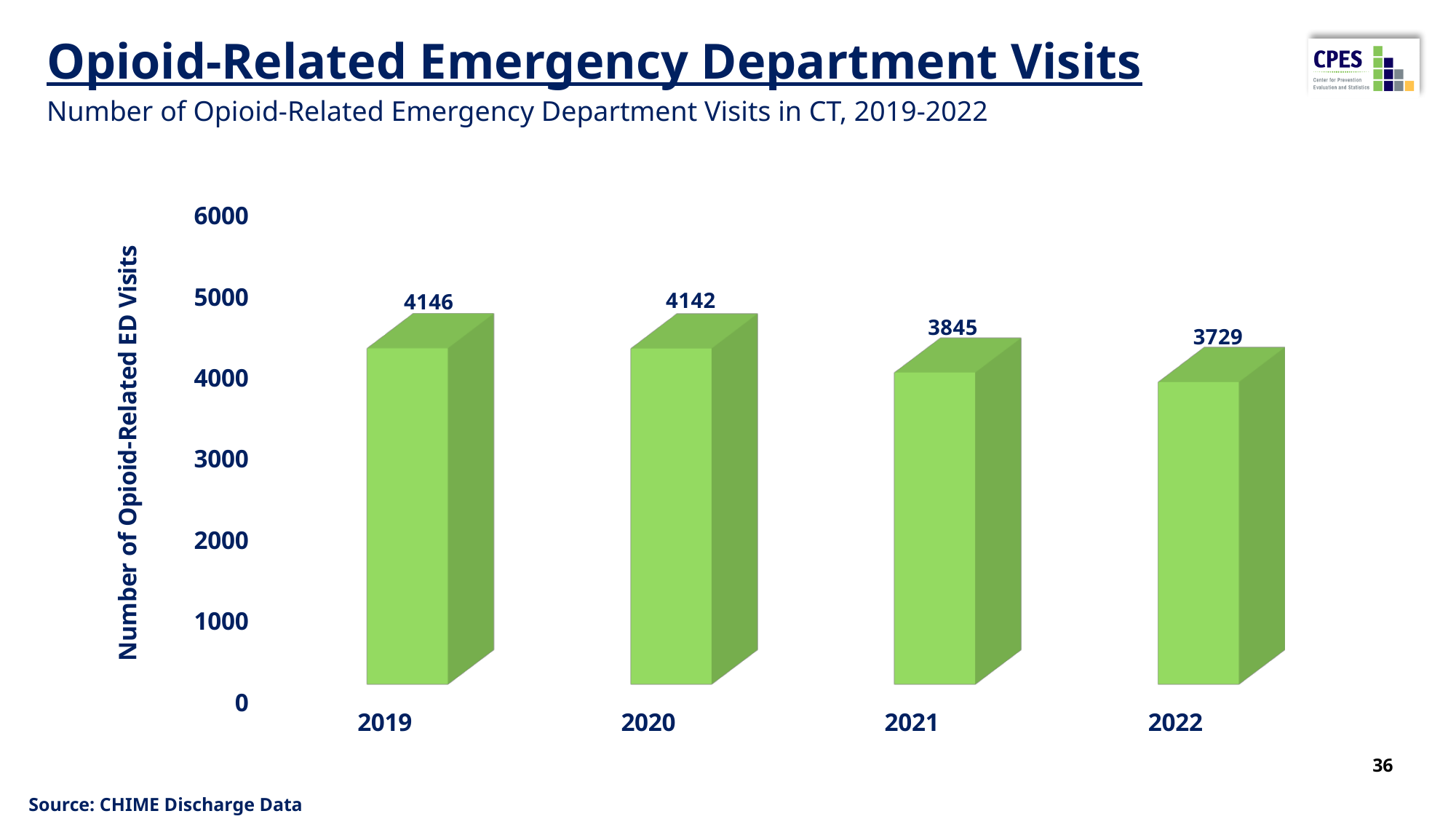
Is the value for 2022 greater or less than 4000? less Which year had more opioid-related ED visits, 2021 or 2022? 2021 Do the values rise or fall from 2019 to 2022? fall What is the difference in opioid-related ED visits between 2020 and 2021? 297 What is the number of opioid-related ED visits in 2022? 3729 Which year has the highest number of opioid-related ED visits? 2019 What kind of chart is shown on the slide? bar chart How many years are shown on the chart? 4 Which year has the lowest number of opioid-related ED visits? 2022 What is the number of opioid-related ED visits in 2019? 4146 What is the number of opioid-related ED visits in 2021? 3845 What is the difference in opioid-related ED visits between 2019 and 2022? 417